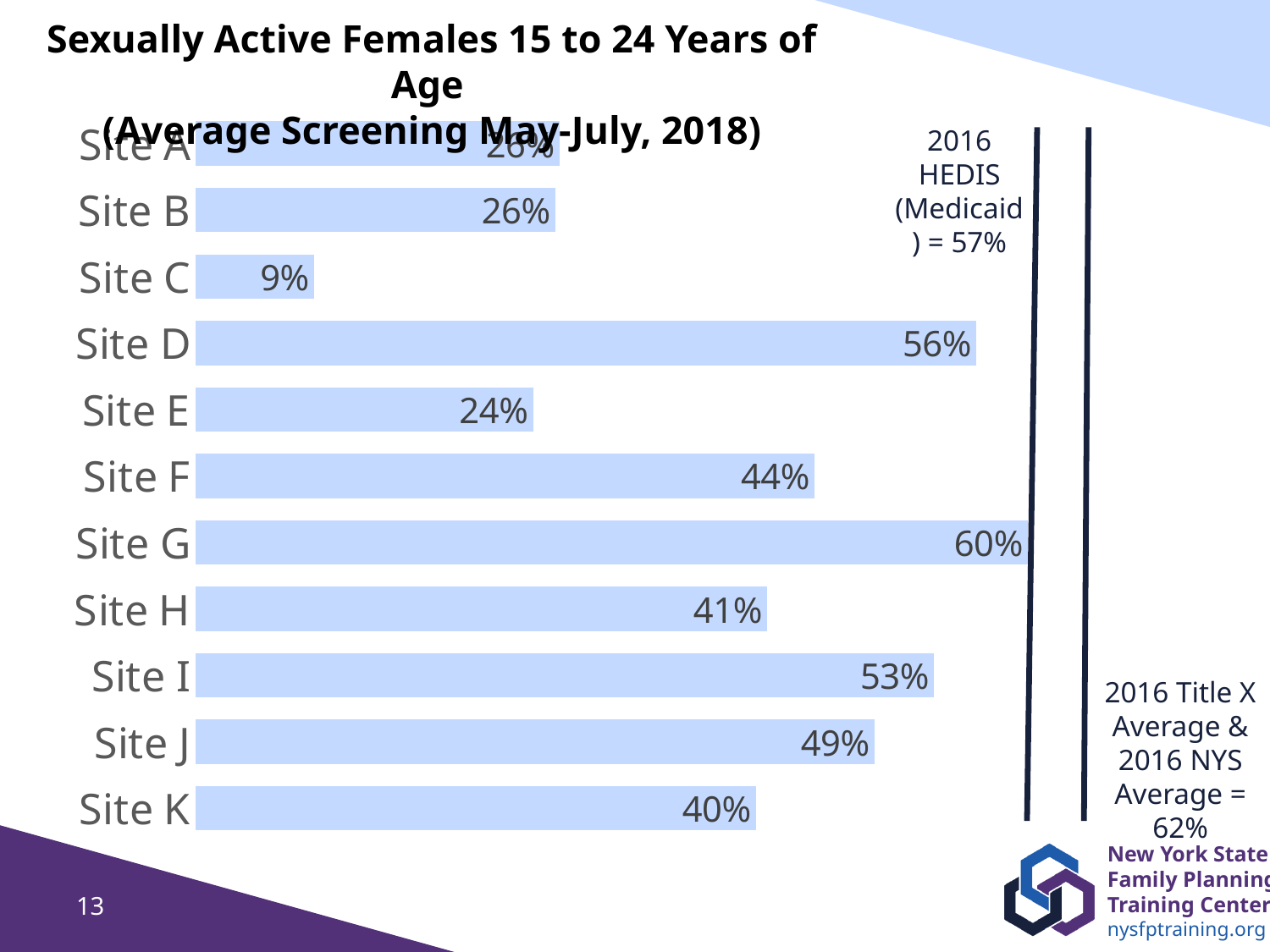
Which site has the lowest value? Site C What is the difference between the values for Site D and Site E? 32% What is the value for Site D? 56% How many sites are shown in the chart? 11 What is the value for Site H? 41% What is the value for Site J? 49% What is the value for Site C? 9% Which site has the highest value? Site G What 2016 HEDIS (Medicaid) reference value is marked on the chart? 57% What kind of chart is shown on the slide? Bar chart Which is larger, the value for Site F or the value for Site H? Site F What is the difference between the values for Site G and Site C? 51%